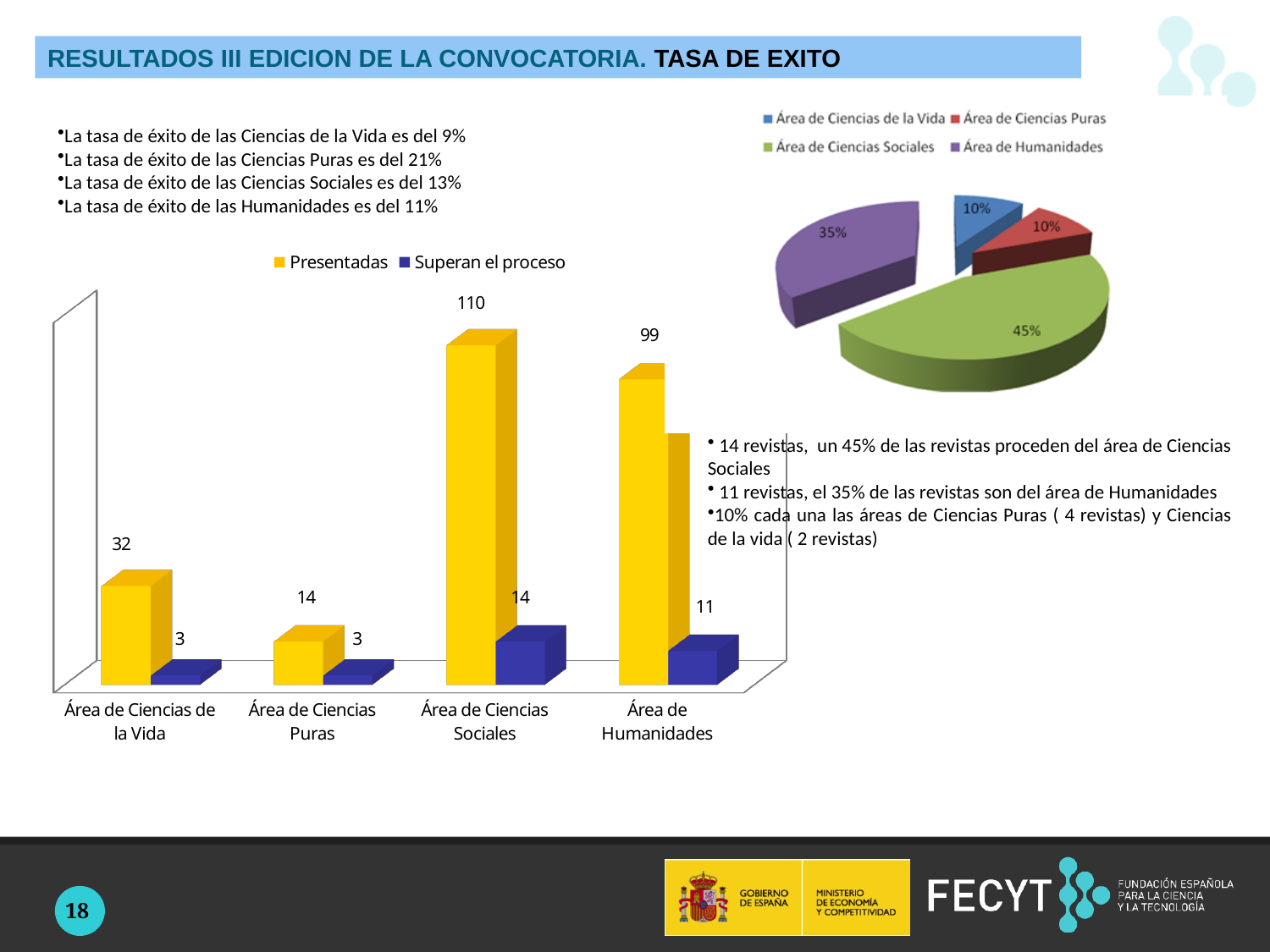
In the pie chart on the right, which area has the largest slice? Área de Ciencias Sociales In the bar chart on the left, what is the difference between the Presentadas values for Área de Ciencias Sociales and Área de Humanidades? 11 What kind of chart is the chart on the left of the slide? Bar chart In the bar chart on the left, which category has the lowest Presentadas value? Área de Ciencias Puras In the pie chart on the right, what share does Área de Humanidades have? 35% In the bar chart on the left, which category has the highest Presentadas value? Área de Ciencias Sociales In the bar chart on the left, what is the Superan el proceso value for Área de Humanidades? 11 In the bar chart on the left, how many categories are shown on the x axis? 4 In the pie chart on the right, what share does Área de Ciencias Sociales have? 45% In the bar chart on the left, which is larger: the Presentadas value for Área de Ciencias de la Vida or for Área de Ciencias Puras? Área de Ciencias de la Vida In the bar chart on the left, how many series does the legend list? 2 In the bar chart on the left, what is the Presentadas value for Área de Ciencias Sociales? 110